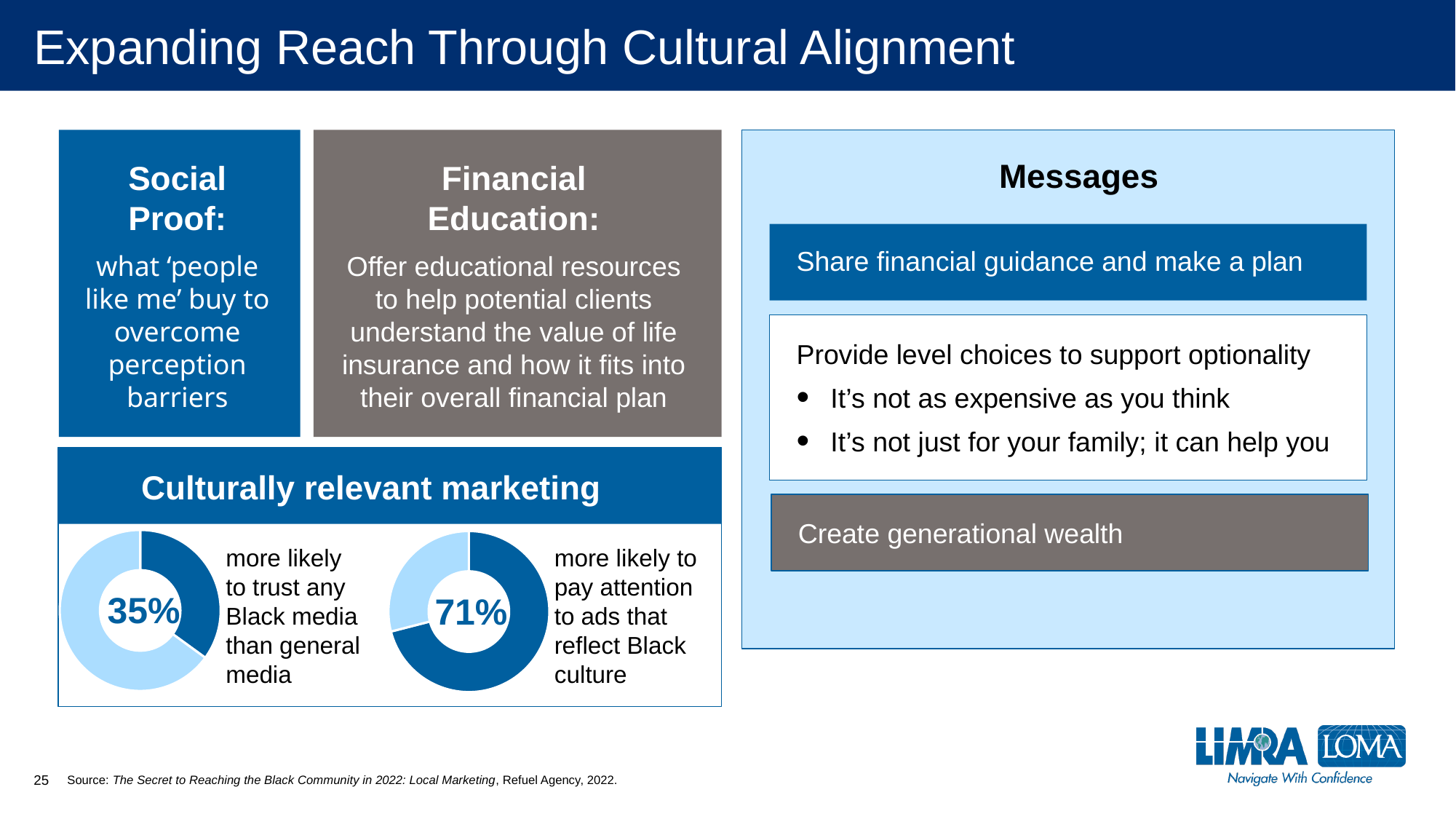
What is the heading above the two donut charts? Culturally relevant marketing In the right donut chart, what share of the ring is not covered by the highlighted 71% slice? 29% What value is given for being more likely to pay attention to ads that reflect Black culture? 71% In the left donut chart, what share of the ring is not covered by the highlighted 35% slice? 65% What colour is the highlighted slice in both donut charts? dark blue What percentage is shown in the left donut chart under 'Culturally relevant marketing'? 35% How many donut charts are shown on the slide? 2 What percentage is shown in the right donut chart under 'Culturally relevant marketing'? 71% What kind of charts are shown in the 'Culturally relevant marketing' section? donut (pie) charts Which is larger: the value for trusting Black media (left chart) or the value for paying attention to ads reflecting Black culture (right chart)? paying attention to ads reflecting Black culture (71%) What value is given for being more likely to trust any Black media than general media? 35% What is the difference in percentage points between the right donut chart value (71%) and the left donut chart value (35%)? 36 percentage points